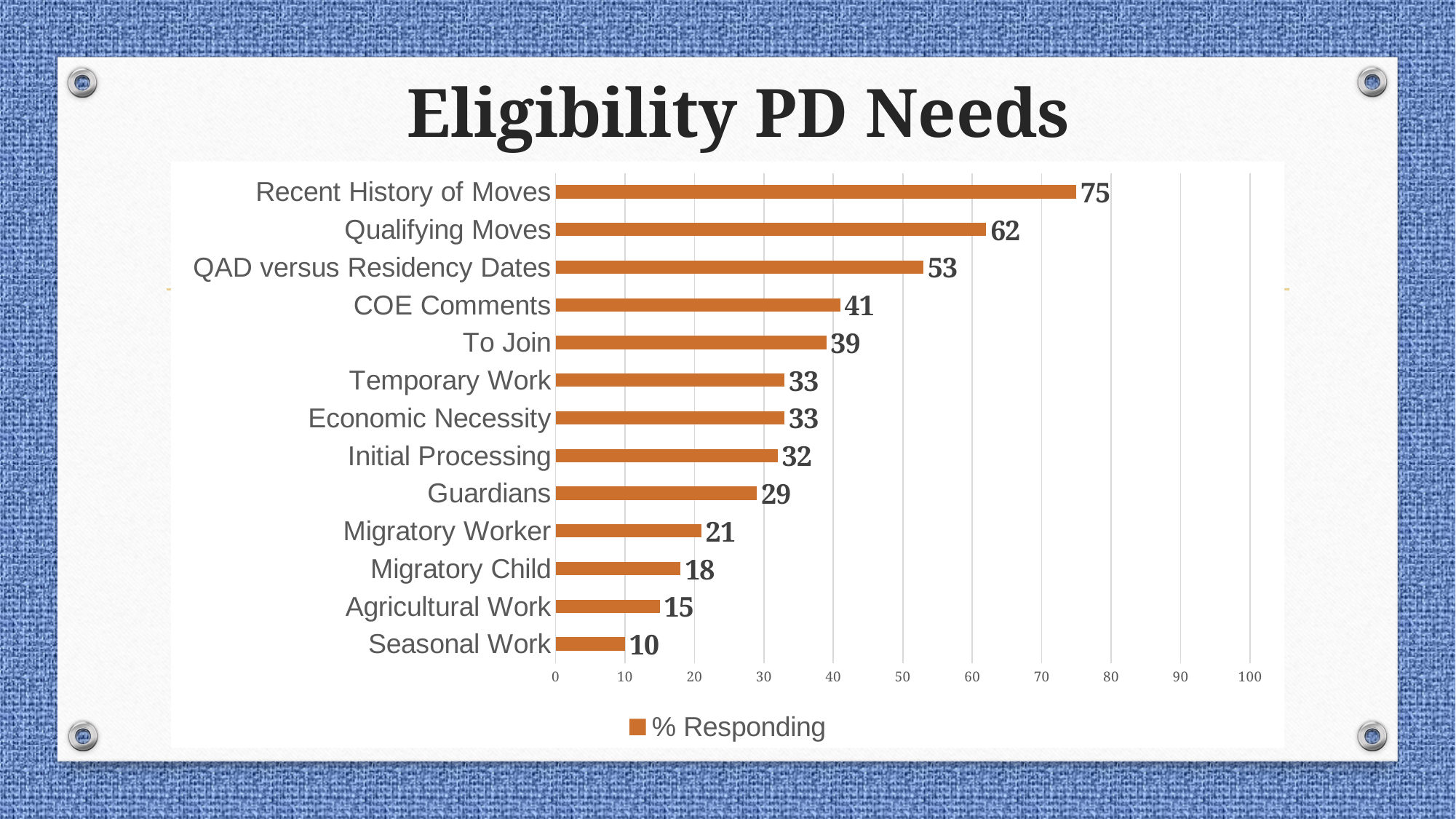
What is the value for Recent History of Moves? 75 How many categories are shown in the chart? 13 What is the difference between the values for Qualifying Moves and QAD versus Residency Dates? 9 What kind of chart is shown on the slide? bar chart What is the value for COE Comments? 41 What is the title of the chart? Eligibility PD Needs What is the value for Guardians? 29 Which category has the lowest value? Seasonal Work Which is larger, the value for To Join or the value for Migratory Worker? To Join How many series does the legend list? 1 Is the value for Initial Processing greater or less than 40? less Which category has the highest value? Recent History of Moves